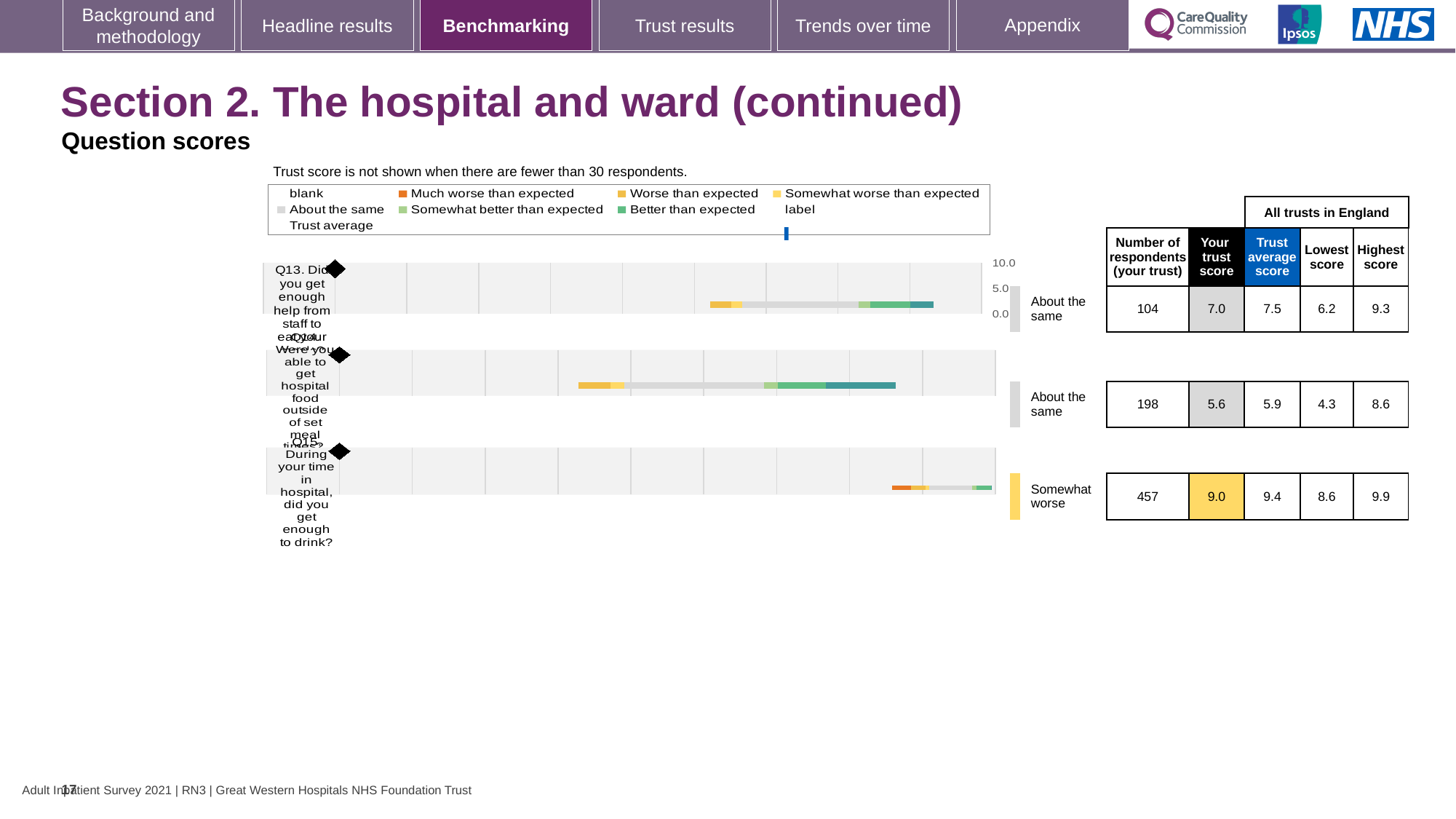
How many respondents from your trust answered Q15 (did you get enough to drink?)? 457 What benchmark category is shown for Q15 (did you get enough to drink?)? Somewhat worse Which question has the lowest 'Your trust score'? Q14 What is the highest score among all trusts in England for Q14? 8.6 What is the lowest score among all trusts in England for Q13? 6.2 How many questions are plotted in the question scores chart? 3 What kind of chart is used to show the question scores on this slide? Bar chart For Q13, which is larger: your trust score or the trust average score? Trust average score Which question has the highest 'Your trust score'? Q15 What is the trust average score for Q14 (Were you able to get hospital food outside of set meal times?)? 5.9 For Q15, what is the difference between the trust average score and your trust score? 0.4 What is the 'Your trust score' for Q13 (Did you get enough help from staff to eat your meals?)? 7.0